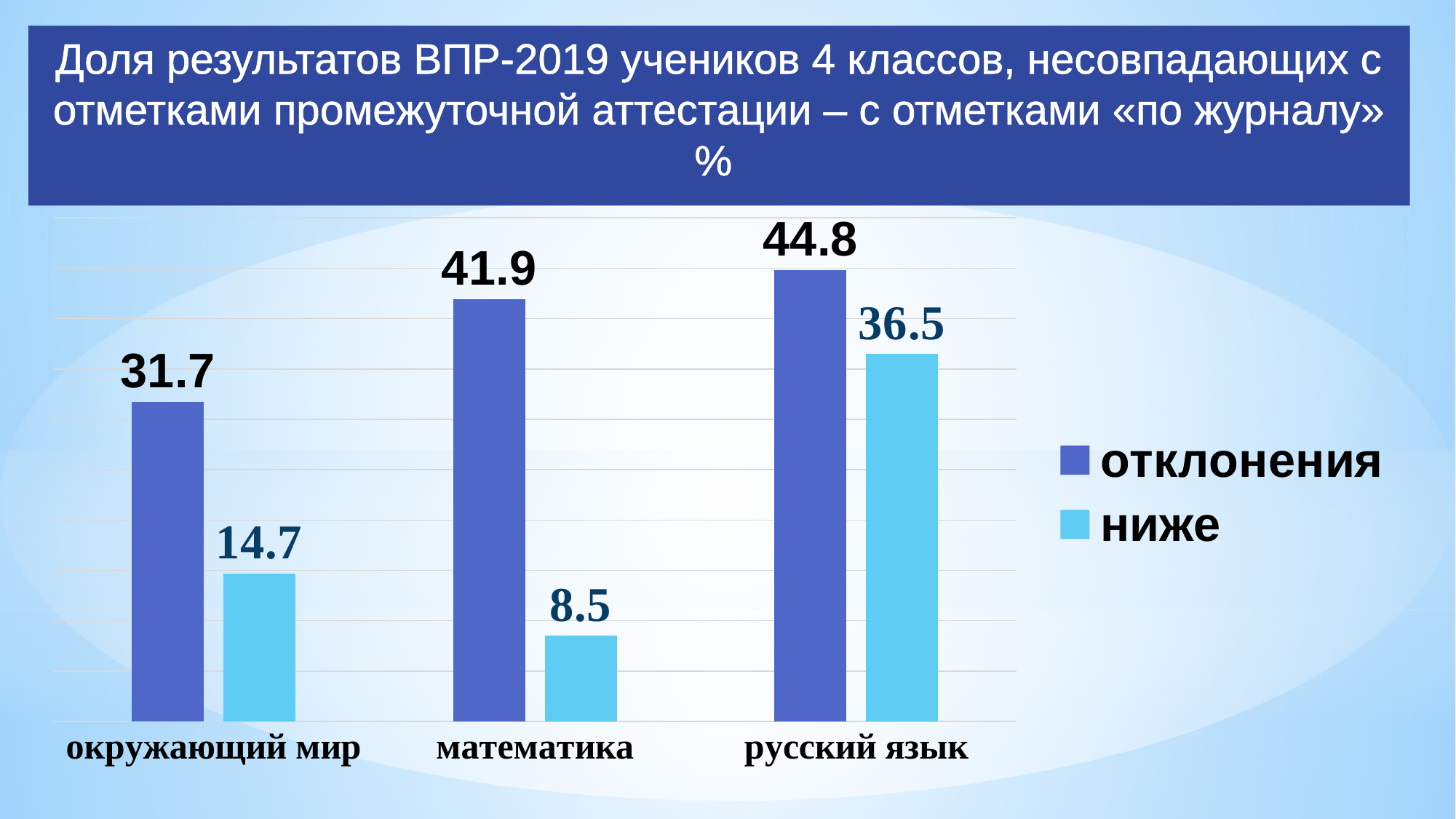
Which is larger: «ниже» for «русский язык» or «отклонения» for «окружающий мир»? «ниже» for «русский язык» How many series does the legend list? 2 What is the value of «отклонения» for «математика»? 41.9 What is the difference between «отклонения» and «ниже» for «математика»? 33.4 How many subjects are shown on the x axis? 3 What is the value of «ниже» for «русский язык»? 36.5 What is the value of «ниже» for «окружающий мир»? 14.7 What is the difference between the «отклонения» values for «русский язык» and «окружающий мир»? 13.1 Do the «отклонения» values rise or fall from left to right across the subjects? rise Which subject has the lowest value for «ниже»? математика Which subject has the highest value for «отклонения»? русский язык What type of chart is shown on the slide? bar chart